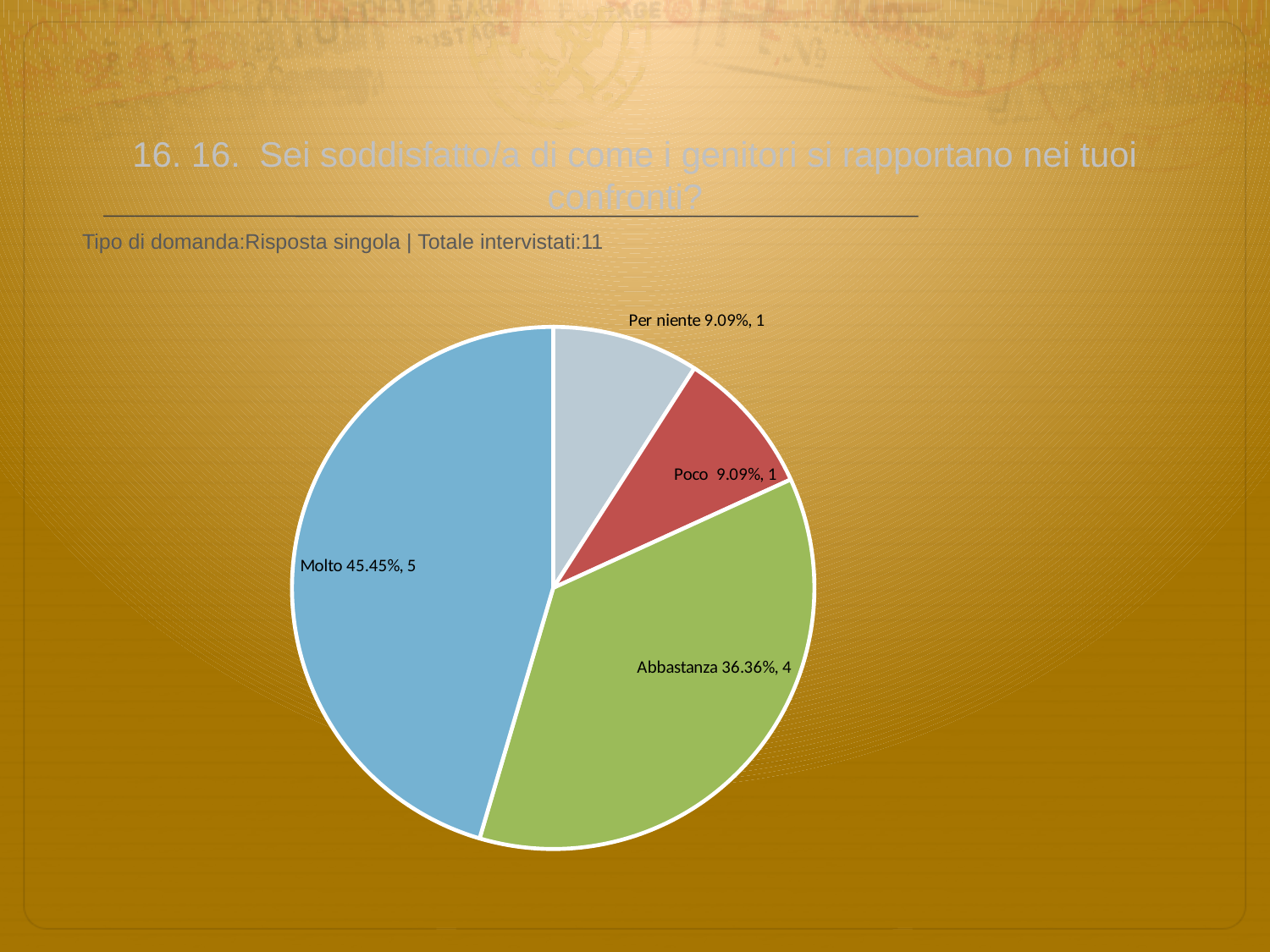
How many slices does the pie chart have? 4 Which is larger, the Abbastanza slice or the Poco slice? Abbastanza What is the difference in respondent count between Molto and Abbastanza? 1 How many respondents chose Poco? 1 What percentage share does the Abbastanza slice have? 36.36% How many respondents chose Molto? 5 What is the total number of respondents shown in the pie chart? 11 Which category has the largest slice of the pie? Molto What kind of chart is shown on the slide? pie chart What colour is the Molto slice? blue What percentage share does the Molto slice have? 45.45% How many respondents chose Abbastanza? 4